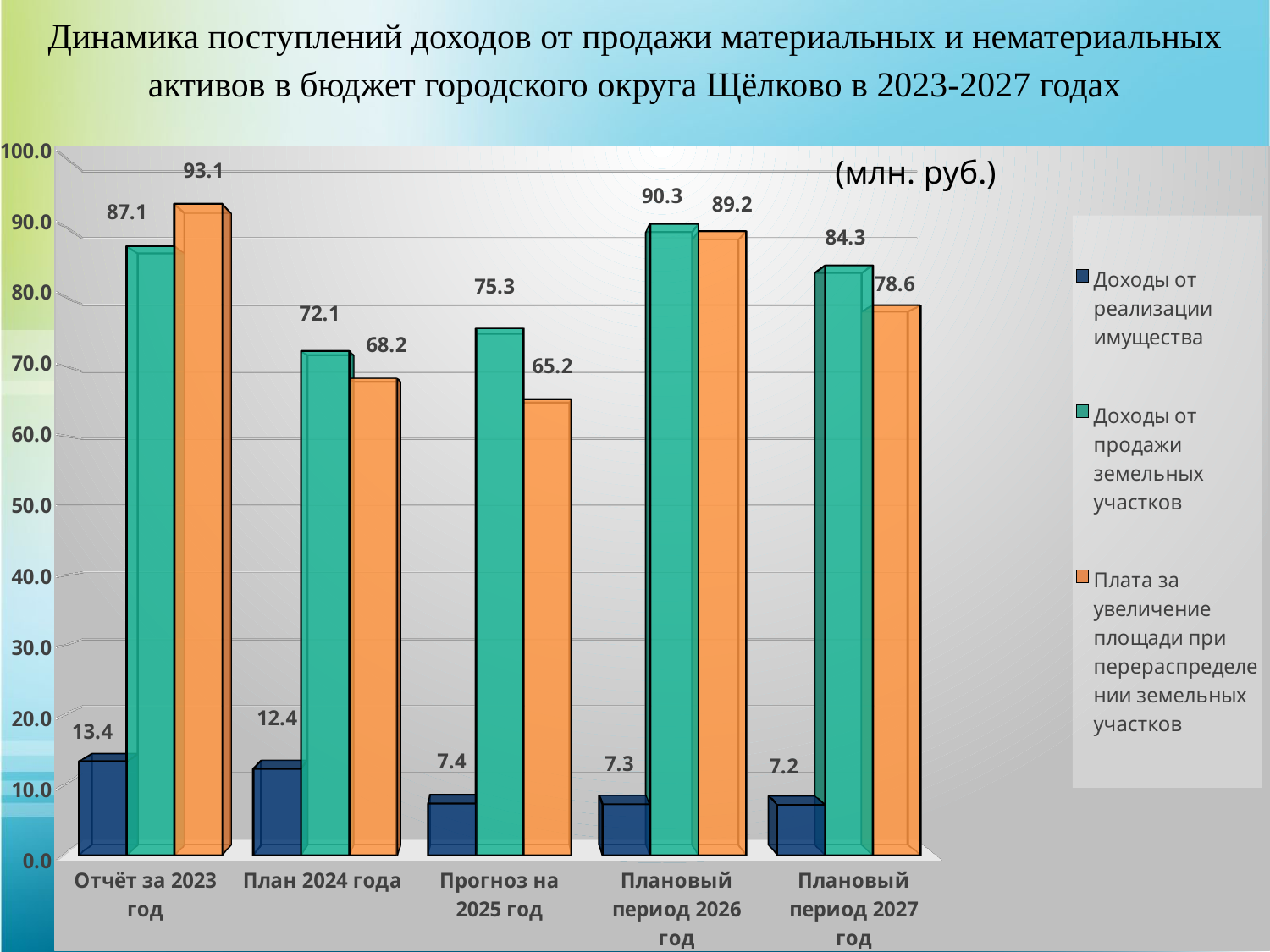
Does "Доходы от реализации имущества" rise or fall from "Отчёт за 2023 год" to "Плановый период 2027 год"? fall What is the difference between "Плата за увеличение площади при перераспределении земельных участков" and "Доходы от продажи земельных участков" in "Отчёт за 2023 год"? 6.0 Is the value for "Доходы от реализации имущества" in "Отчёт за 2023 год" greater or less than 10.0? greater How many categories are shown on the x axis? 5 What is the value for "Доходы от продажи земельных участков" in "Отчёт за 2023 год"? 87.1 In which category is "Доходы от реализации имущества" lowest? Плановый период 2027 год In which category is "Доходы от продажи земельных участков" highest? Плановый период 2026 год What kind of chart is shown on the slide? bar chart What is the value for "Плата за увеличение площади при перераспределении земельных участков" in "Плановый период 2027 год"? 78.6 How many series does the legend list? 3 What is the value for "Доходы от реализации имущества" in "План 2024 года"? 12.4 Which is larger in "Прогноз на 2025 год": "Доходы от продажи земельных участков" or "Плата за увеличение площади при перераспределении земельных участков"? Доходы от продажи земельных участков